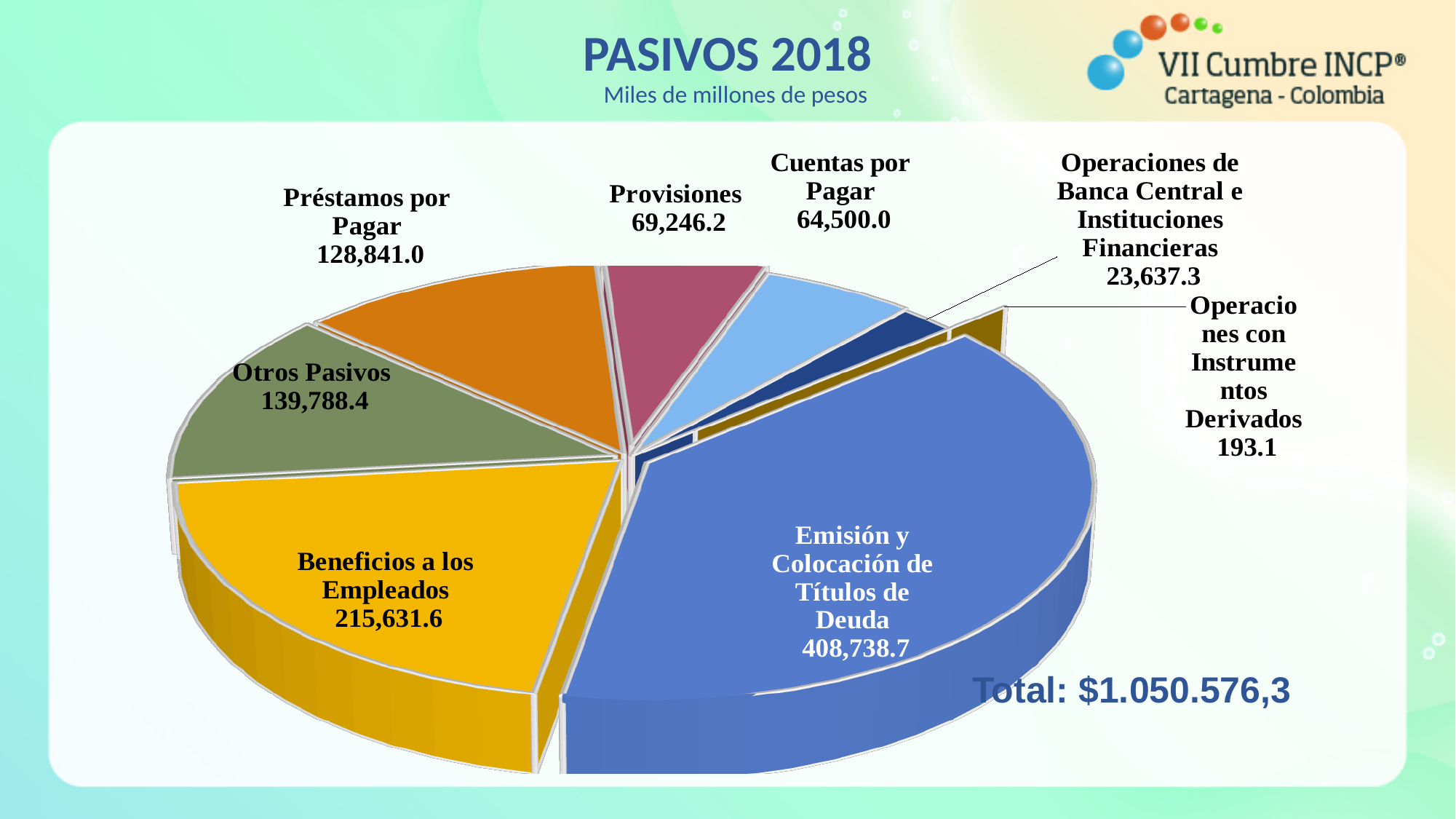
How many categories are shown in the pie chart? 8 Which is larger, Otros Pasivos or Préstamos por Pagar? Otros Pasivos What kind of chart is shown on the slide? Pie chart What is the value for Provisiones? 69,246.2 What is the value for Operaciones de Banca Central e Instituciones Financieras? 23,637.3 What is the difference between Provisiones and Cuentas por Pagar? 4,746.2 Which category has the largest slice of the pie? Emisión y Colocación de Títulos de Deuda What is the difference between Beneficios a los Empleados and Otros Pasivos? 75,843.2 What is the value for Beneficios a los Empleados? 215,631.6 What is the title of the chart? PASIVOS 2018 What total is printed on the slide for the pie chart? $1.050.576,3 Which category has the smallest value? Operaciones con Instrumentos Derivados